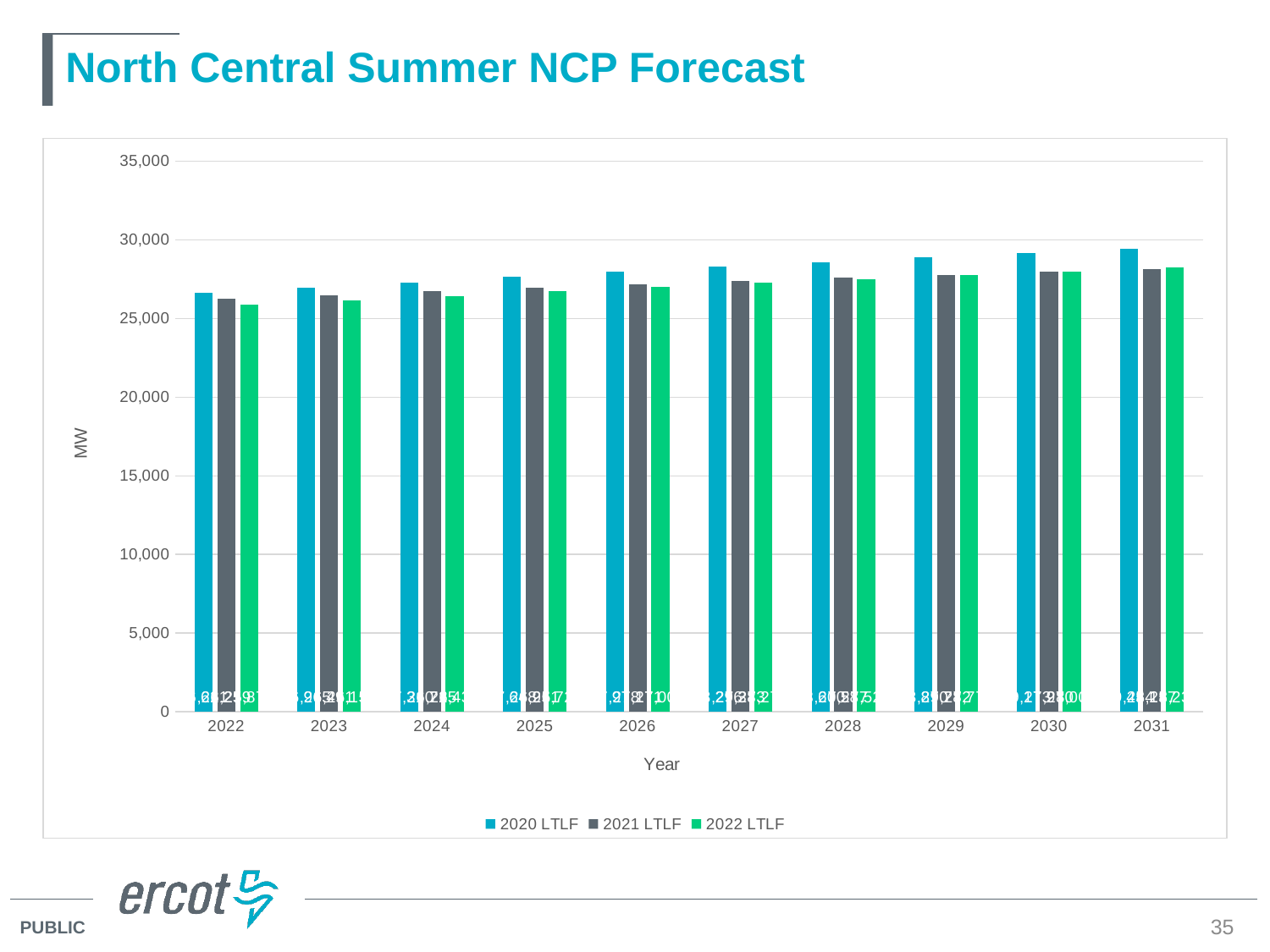
How many years are shown on the x axis? 10 Is the 2020 LTLF value for 2031 greater or less than 30,000? less What kind of chart is shown on the slide? bar chart Which is larger, the 2020 LTLF value for 2031 or the 2020 LTLF value for 2022? 2020 LTLF value for 2031 Which series has the highest value in 2031? 2020 LTLF Is the 2022 LTLF value for 2022 greater or less than 25,000? greater Do the 2020 LTLF values rise or fall from 2022 to 2031? rise What is the title of the chart? North Central Summer NCP Forecast Is the 2021 LTLF value for 2026 greater or less than 25,000? greater What is the label on the y axis? MW How many series does the legend list? 3 Which series has the highest value in 2022? 2020 LTLF